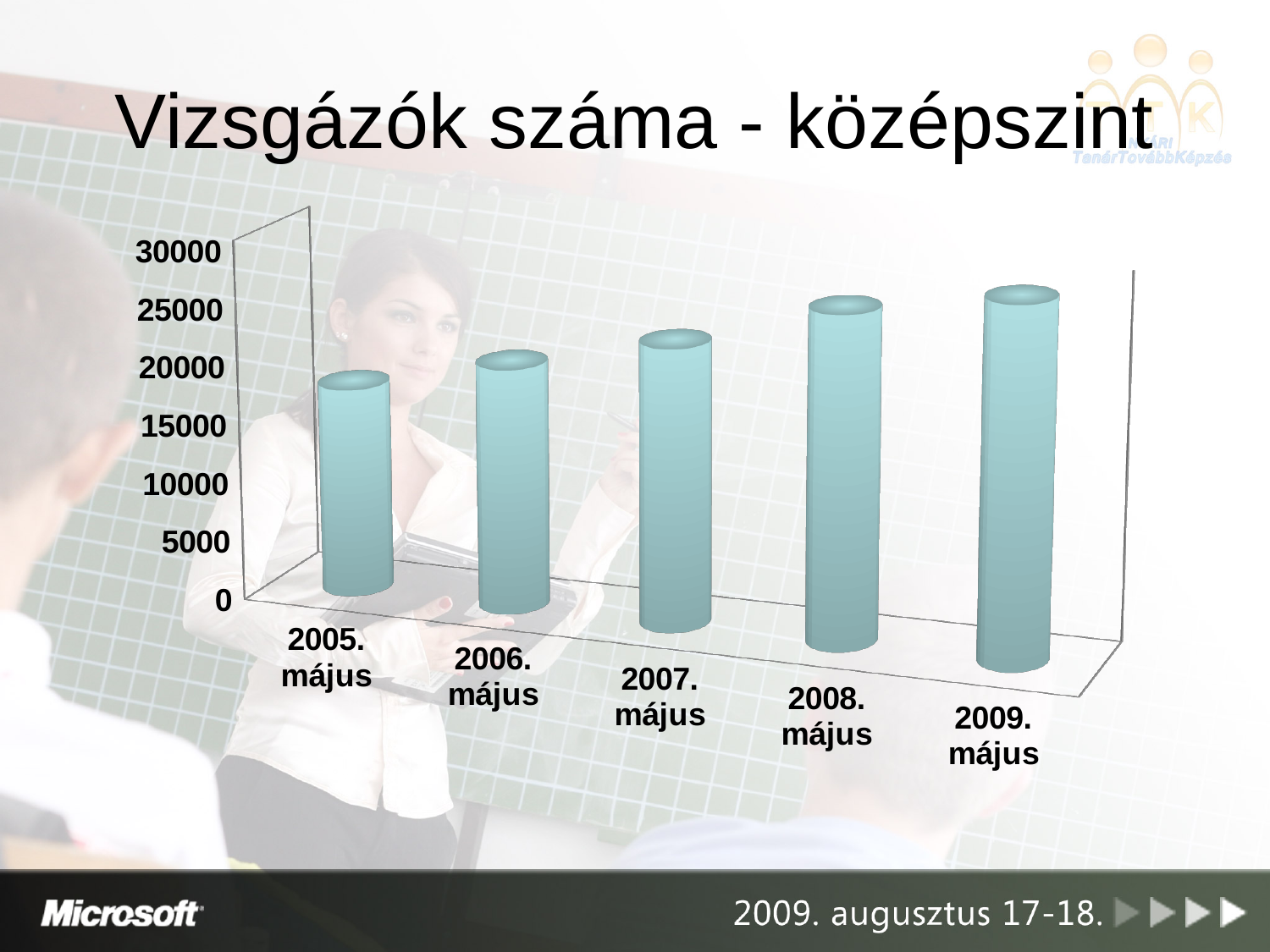
Do the values rise or fall from 2005. május to 2009. május? rise Is the value for 2008. május greater or less than 10000? greater Which is larger, the value for 2005. május or the value for 2009. május? 2009. május What is the highest value shown on the vertical axis? 30000 Is the value for 2009. május greater or less than 15000? greater Is the value for 2005. május greater or less than 25000? less What is the title of the chart? Vizsgázók száma - középszint Which category has the lowest value? 2005. május Which is larger, the value for 2006. május or the value for 2008. május? 2008. május Which category has the highest value? 2009. május How many categories are shown on the x axis of the chart? 5 What kind of chart is shown on the slide? bar chart